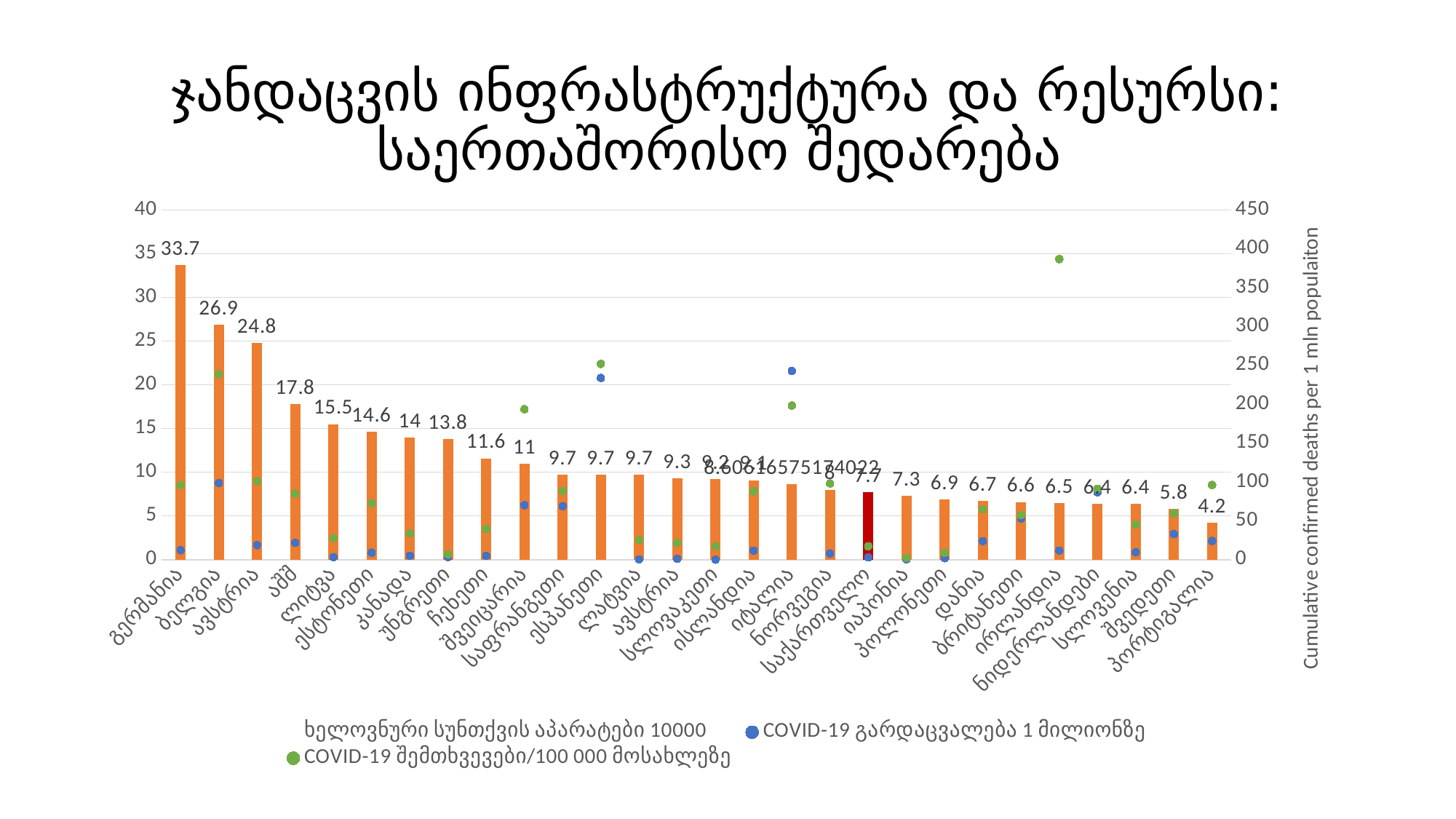
Which has a larger bar value, ავსტრია (third bar) or აშშ? ავსტრია What kind of chart is used for the ventilator values? bar chart How many countries are shown on the x axis? 28 Which country has the highest bar value? გერმანია Do the bar values rise or fall from left to right along the x axis? fall What is the value of the bar for აშშ? 17.8 What is the difference between the bar values for გერმანია and ბელგია? 6.8 What is the value of the bar for საქართველო (the red bar)? 7.7 How many series does the legend list? 3 What is the value of the bar for გერმანია? 33.7 Which country has the lowest bar value? პორტიგალია Is the green point for ირლანდია on the right axis greater or less than 350? greater